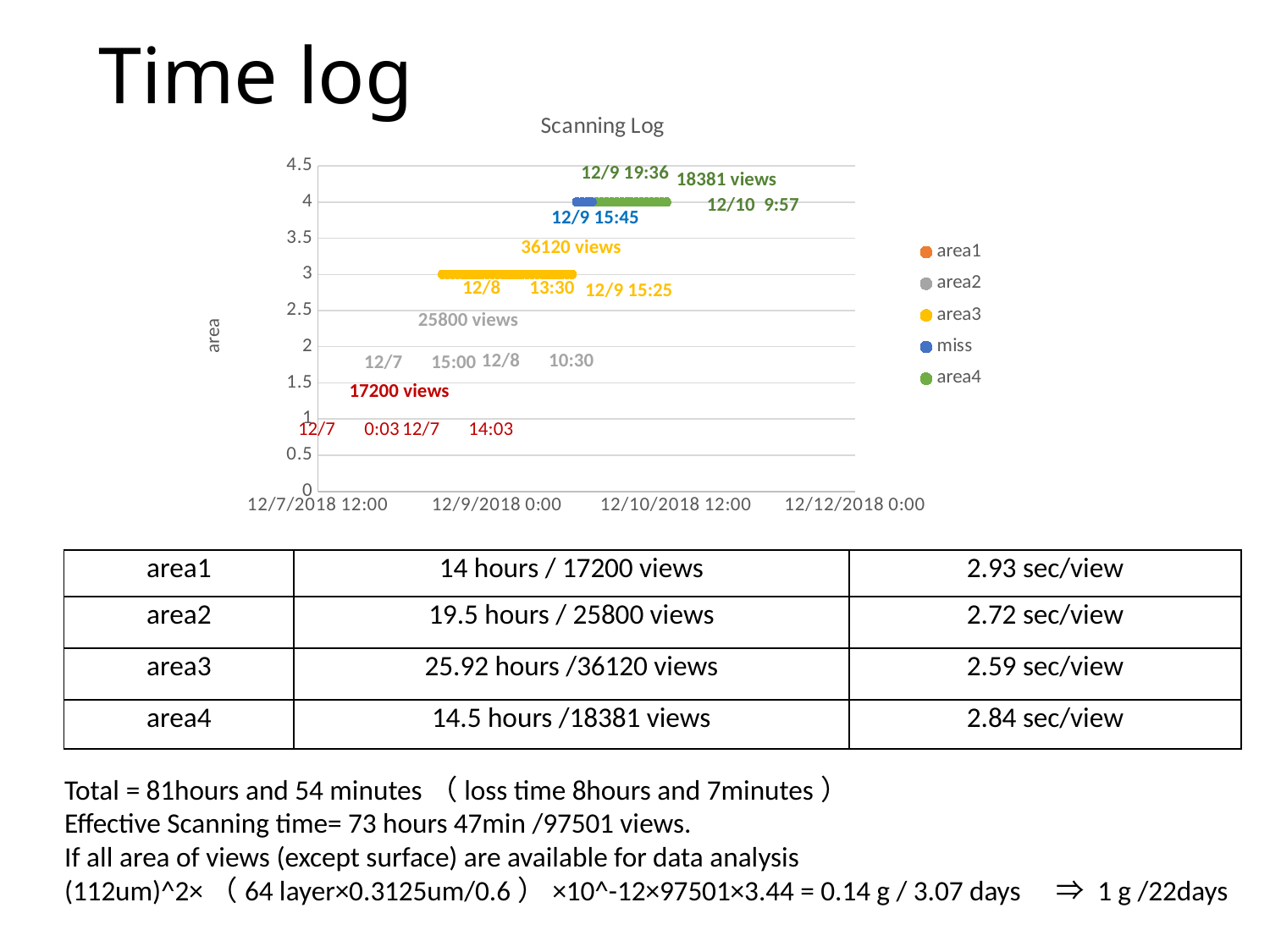
What is the title of the chart? Scanning Log Which area has the lowest number of views labelled in the chart? area1 Which has more views according to the chart labels, area2 or area4? area2 What is the end time label shown for area4 in the chart? 12/10 9:57 What is the difference in views between area3 and area1 as labelled in the chart? 18920 What is the views label shown for area1 in the chart? 17200 views What is the views label shown for area4 in the chart? 18381 views How many series does the chart legend list? 5 What type of chart is shown on the slide? scatter chart What is the label of the y axis of the chart? area What is the views label shown for area3 in the chart? 36120 views Which area has the highest number of views labelled in the chart? area3